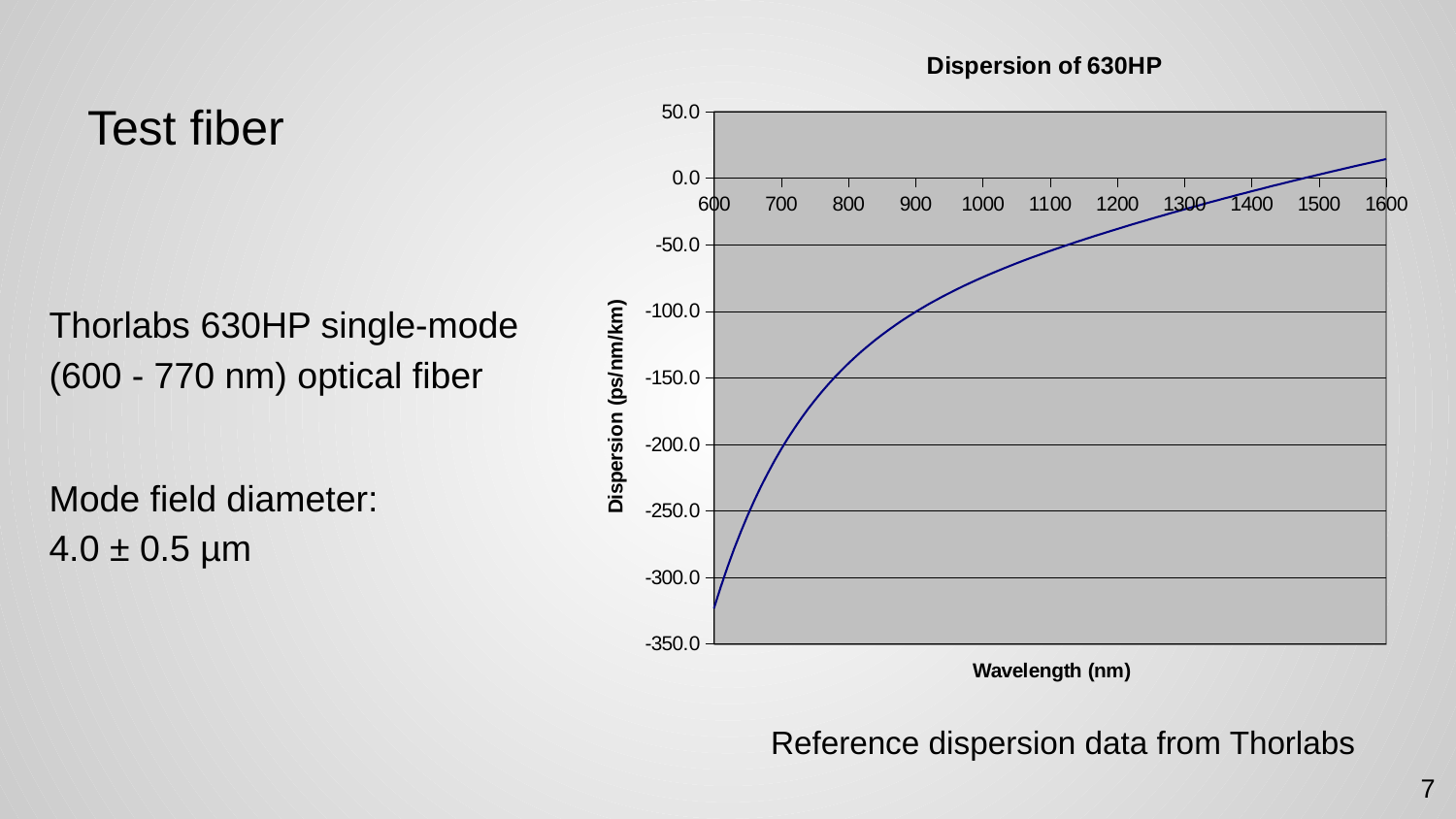
Is the dispersion at 700 nm greater or less than -150? less Does the dispersion rise or fall as wavelength increases from 600 nm to 1600 nm? rise Is the dispersion at 1200 nm greater or less than -50? greater What is the title of the chart? Dispersion of 630HP What is the label of the y axis of the chart? Dispersion (ps/nm/km) Is the dispersion at 800 nm greater or less than -100? less Which wavelength shown on the x axis has the lowest dispersion? 600 What kind of chart is shown on the slide? line chart